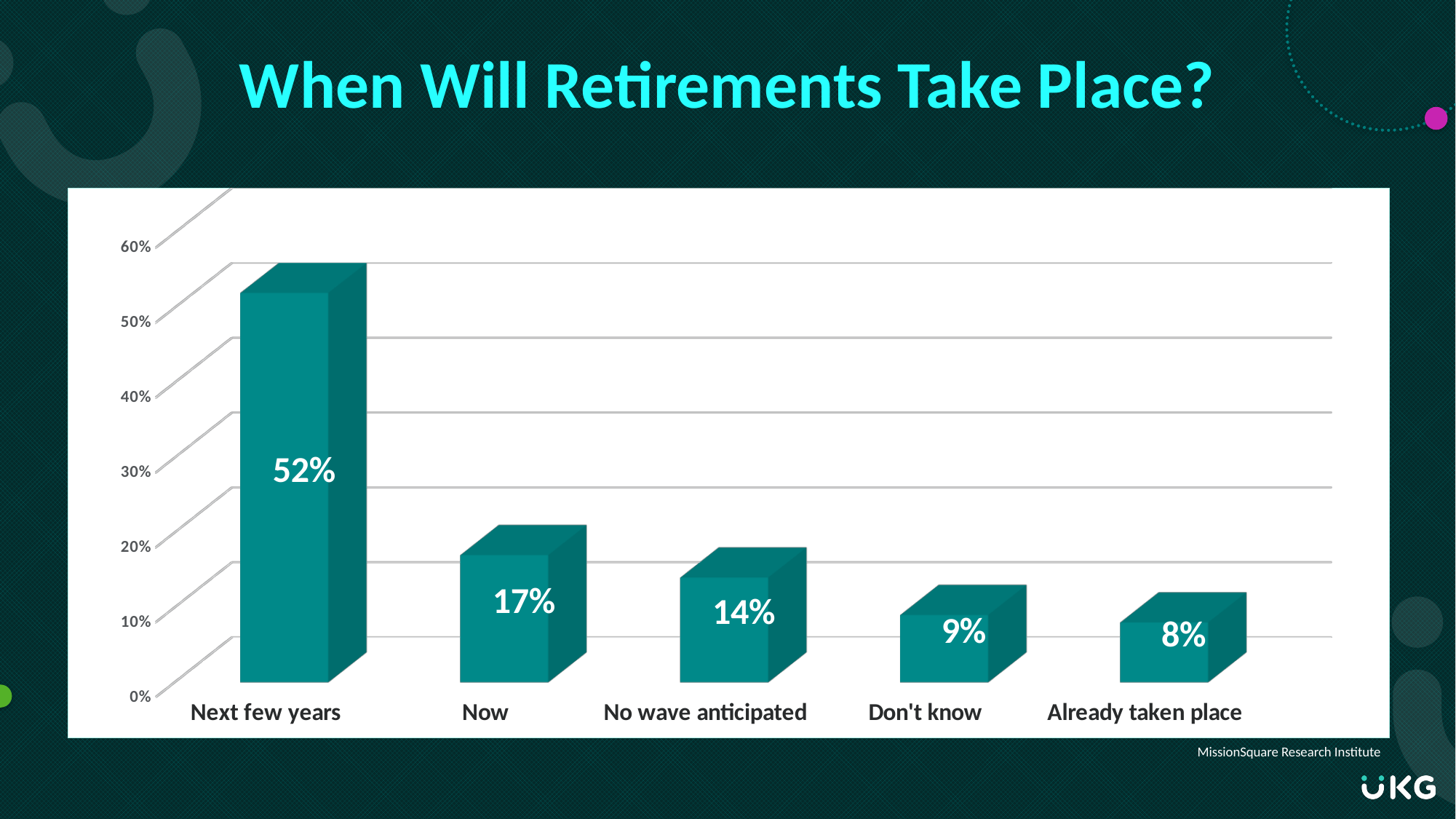
What is the value for 'Now'? 17% What kind of chart is shown on the slide? Bar chart Which is larger, the value for 'Now' or the value for 'No wave anticipated'? Now What is the value for 'Don't know'? 9% Which category has the lowest value? Already taken place Which category has the highest value? Next few years What is the difference between the values for 'Next few years' and 'Now'? 35% What is the title of the chart on the slide? When Will Retirements Take Place? How many categories are shown on the chart? 5 What is the value for 'Already taken place'? 8% What is the value for 'No wave anticipated'? 14% What percentage of respondents said retirements will take place in the next few years? 52%